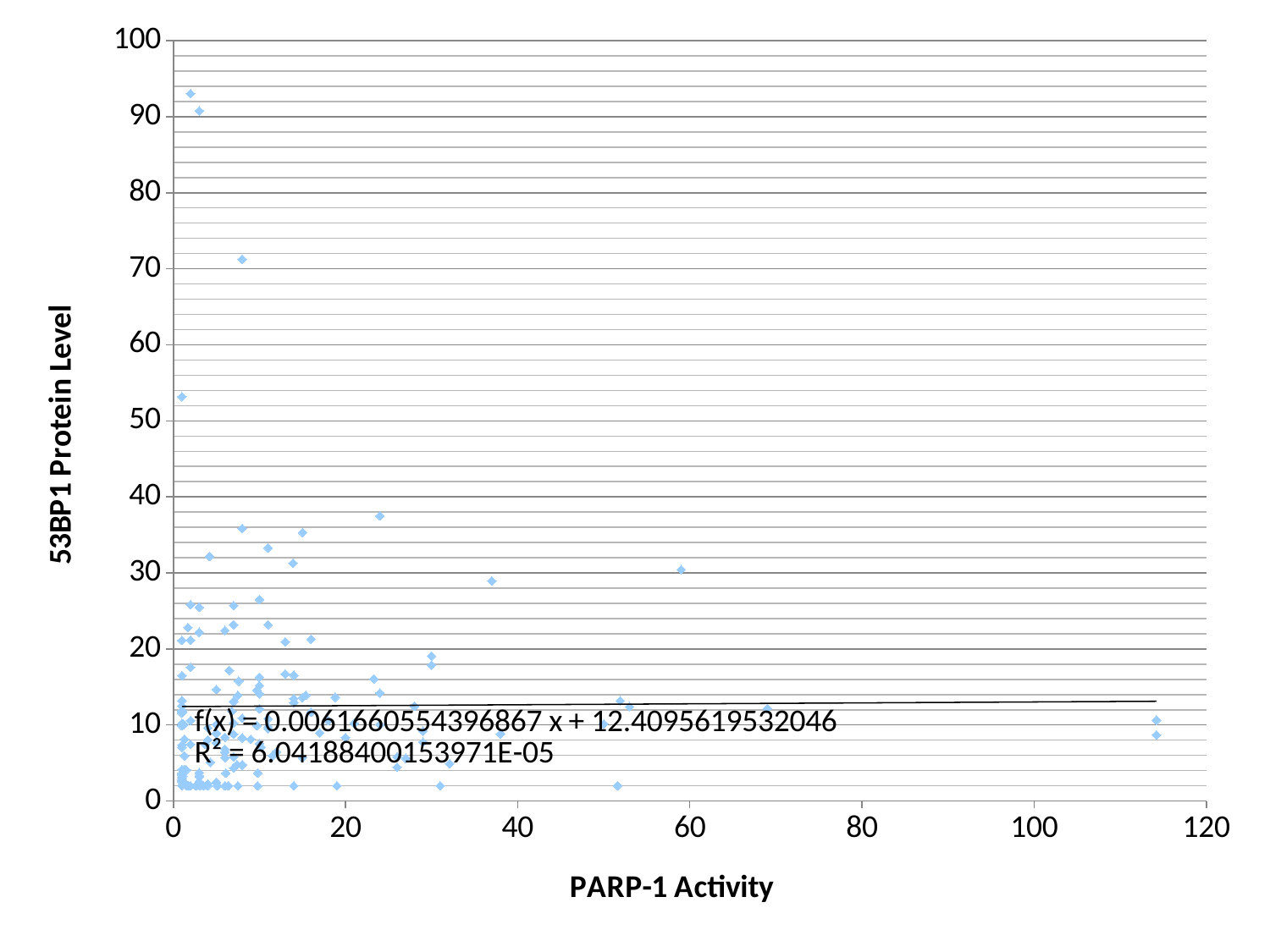
Does the fitted trendline rise steeply, fall steeply, or stay nearly flat as PARP-1 Activity increases? Nearly flat Are most of the data points located at PARP-1 Activity values less than or greater than 40? less Is the highest 53BP1 Protein Level value among the points greater or less than 90? greater What is the title of the y axis? 53BP1 Protein Level What is the title of the x axis? PARP-1 Activity Is the largest PARP-1 Activity value among the points greater or less than 100? greater What is the trendline equation printed on the chart? f(x) = 0.0061660554396867 x + 12.4095619532046 What R² value is printed on the chart? 6.04188400153971E-05 What kind of chart is shown on the slide? Scatter plot What is the maximum value shown on the x axis? 120 What is the maximum value shown on the y axis? 100